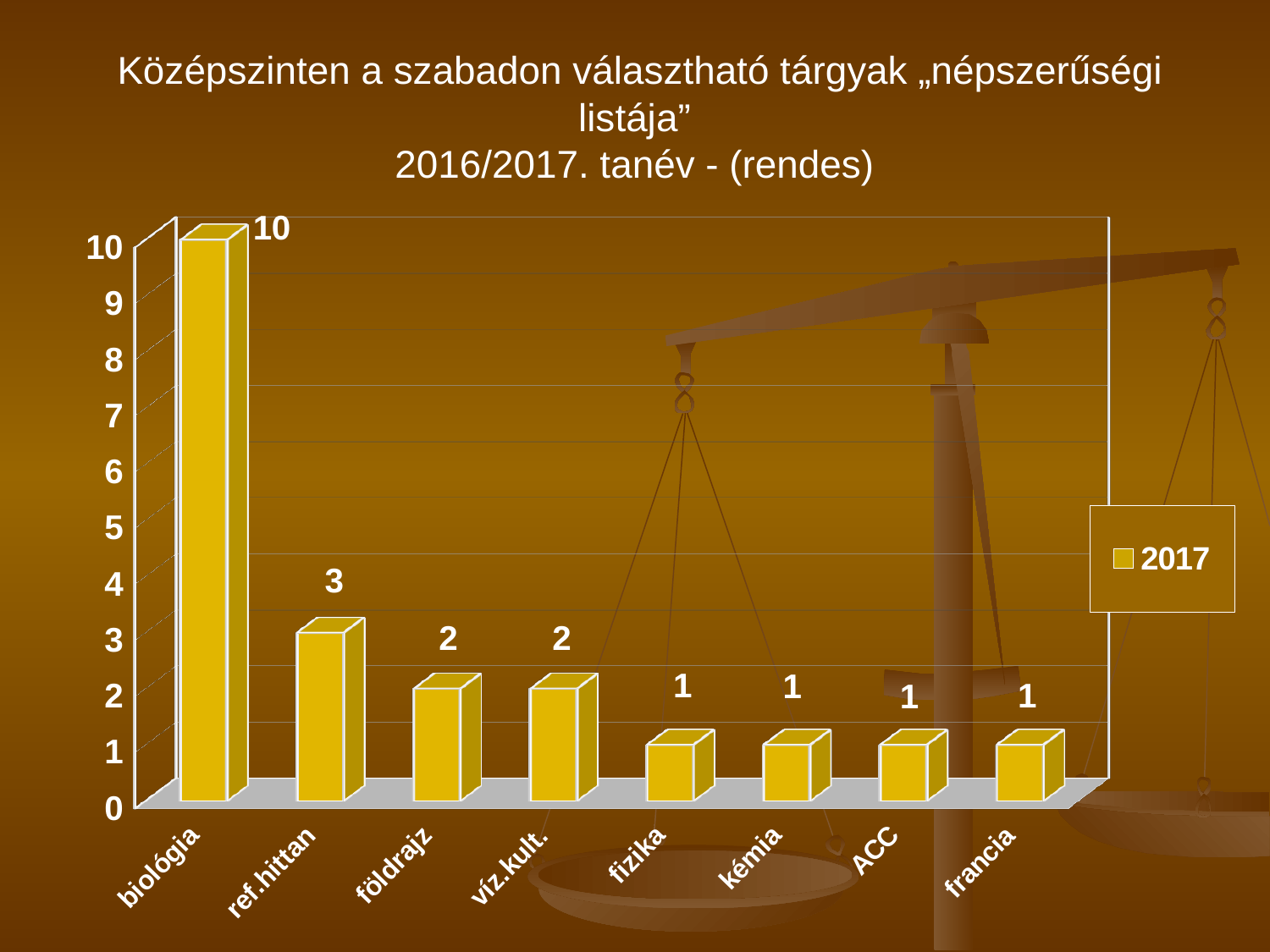
What is the value for ref.hittan? 3 Which is larger, the value for ref.hittan or the value for víz.kult.? ref.hittan What is the value for földrajz? 2 What is the value for kémia? 1 How many series does the legend list? 1 What kind of chart is shown on the slide? bar chart How many categories are shown on the x axis? 8 What is the difference between the values for biológia and ref.hittan? 7 Is the value for biológia greater or less than 5? greater Which category has the highest value? biológia What is the value for biológia? 10 What series name is shown in the legend? 2017